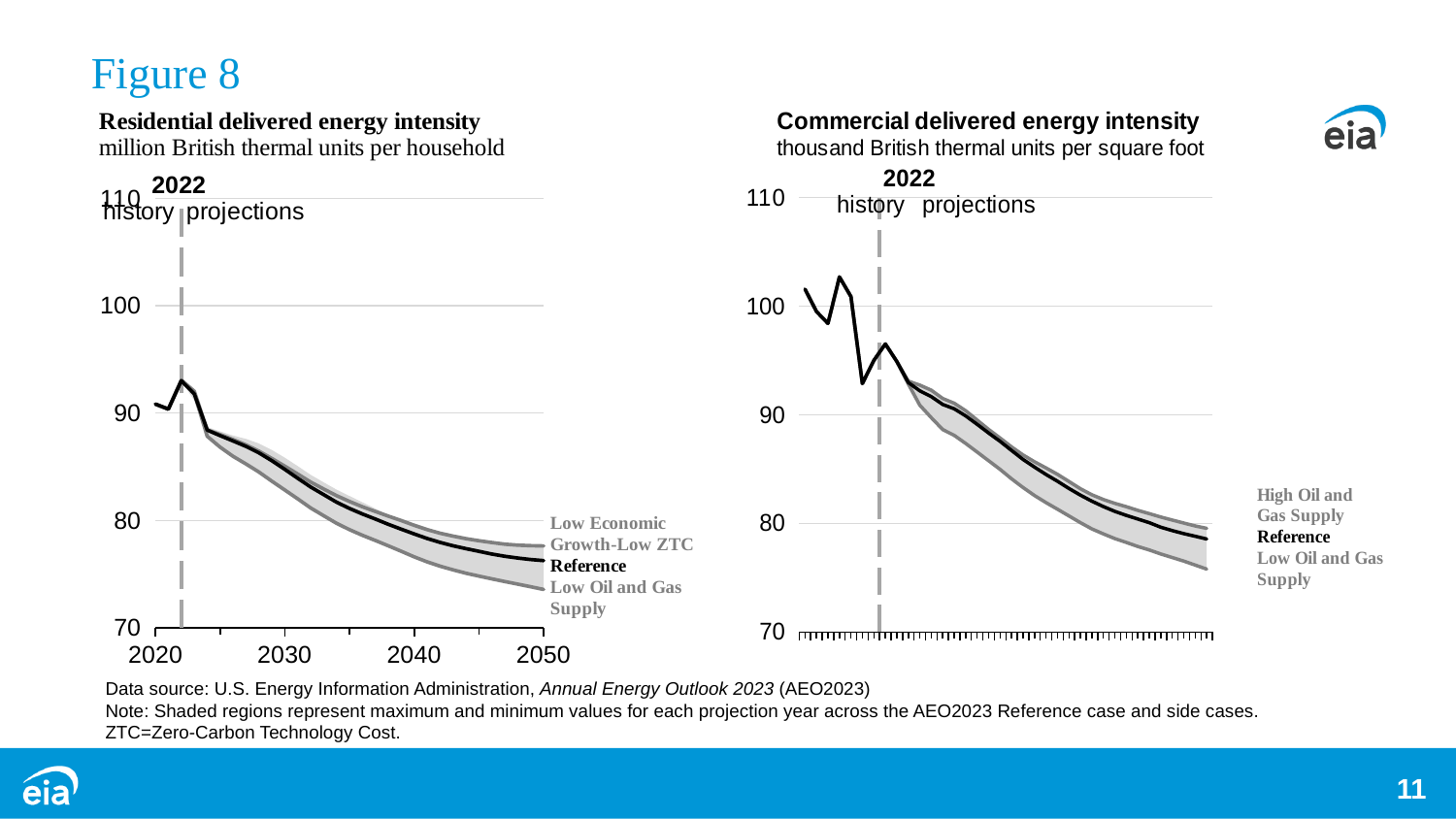
In the Residential delivered energy intensity chart, do the projected values rise or fall from 2022 to 2050? fall In the Commercial delivered energy intensity chart, do the projected values rise or fall after 2022? fall Which year does the vertical dashed line separating history from projections mark on both charts? 2022 In the Residential delivered energy intensity chart, which case is higher in 2050: Low Economic Growth-Low ZTC or Low Oil and Gas Supply? Low Economic Growth-Low ZTC In the Commercial delivered energy intensity chart, which case ends higher: High Oil and Gas Supply or Low Oil and Gas Supply? High Oil and Gas Supply In the Commercial delivered energy intensity chart, is the Reference value at the end of the projection period greater or less than 80? less In the Residential delivered energy intensity chart, is the Reference value in 2050 greater or less than 80? less What unit is used on the Residential delivered energy intensity chart? million British thermal units per household In the Commercial delivered energy intensity chart, is the highest historical value greater or less than 100? greater How many cases are labeled on the Commercial delivered energy intensity chart? 3 What kind of chart is the Residential delivered energy intensity chart? line chart